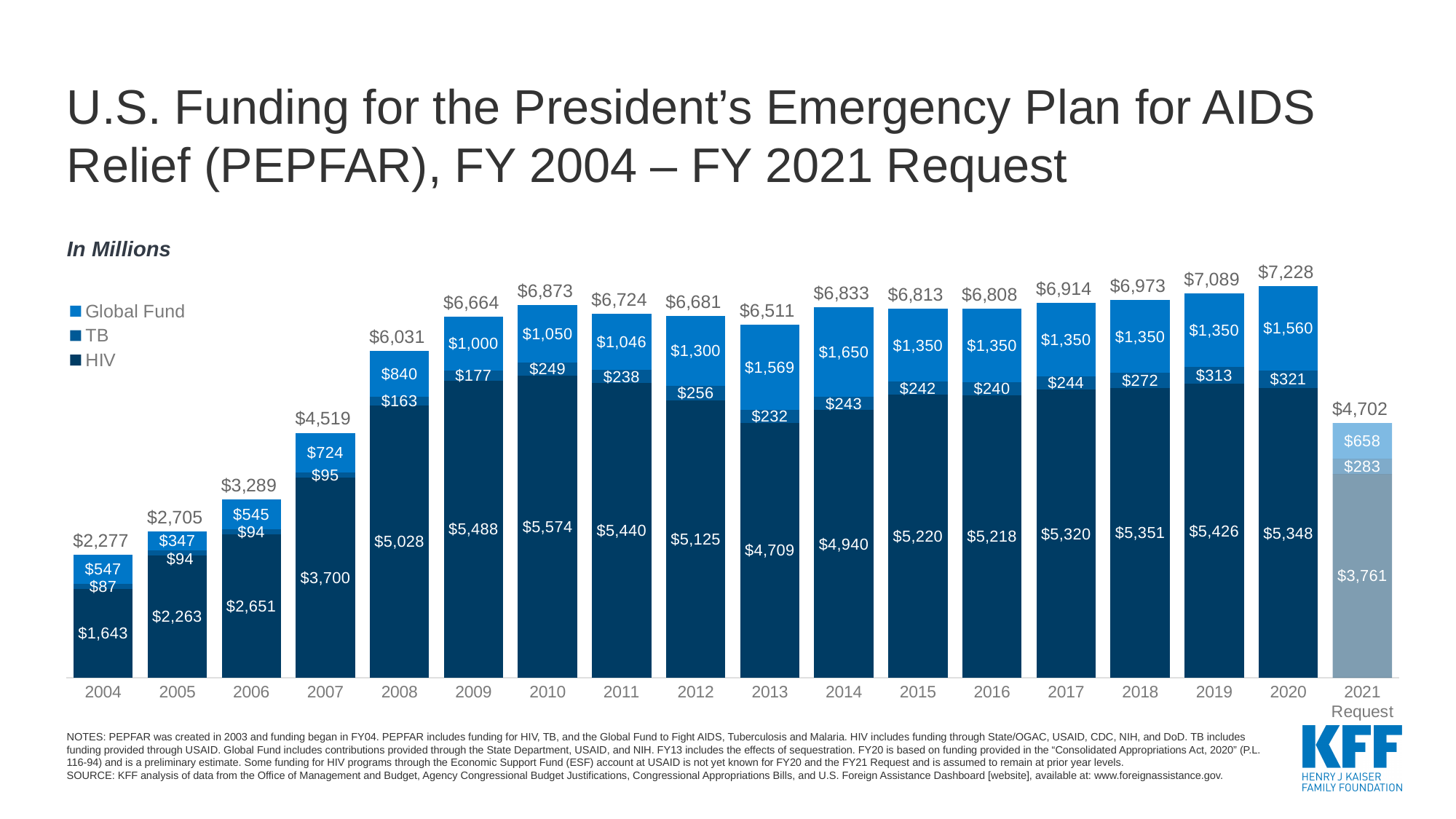
What is the total funding shown for the 2021 Request bar? $4,702 Which year has the lowest total PEPFAR funding? 2004 What is the HIV funding value for 2010? $5,574 What kind of chart is shown on the slide? Stacked bar chart How many series does the legend list? 3 Which is larger, the HIV value for 2013 or the HIV value for 2014? 2014 Which year has the highest total PEPFAR funding? 2020 What is the difference between the total funding in 2020 and in 2019? $139 How many bars (fiscal years) are shown on the chart? 18 Did total PEPFAR funding rise or fall from 2004 to 2008? Rise What is the Global Fund value for 2014? $1,650 What is the TB value for 2020? $321